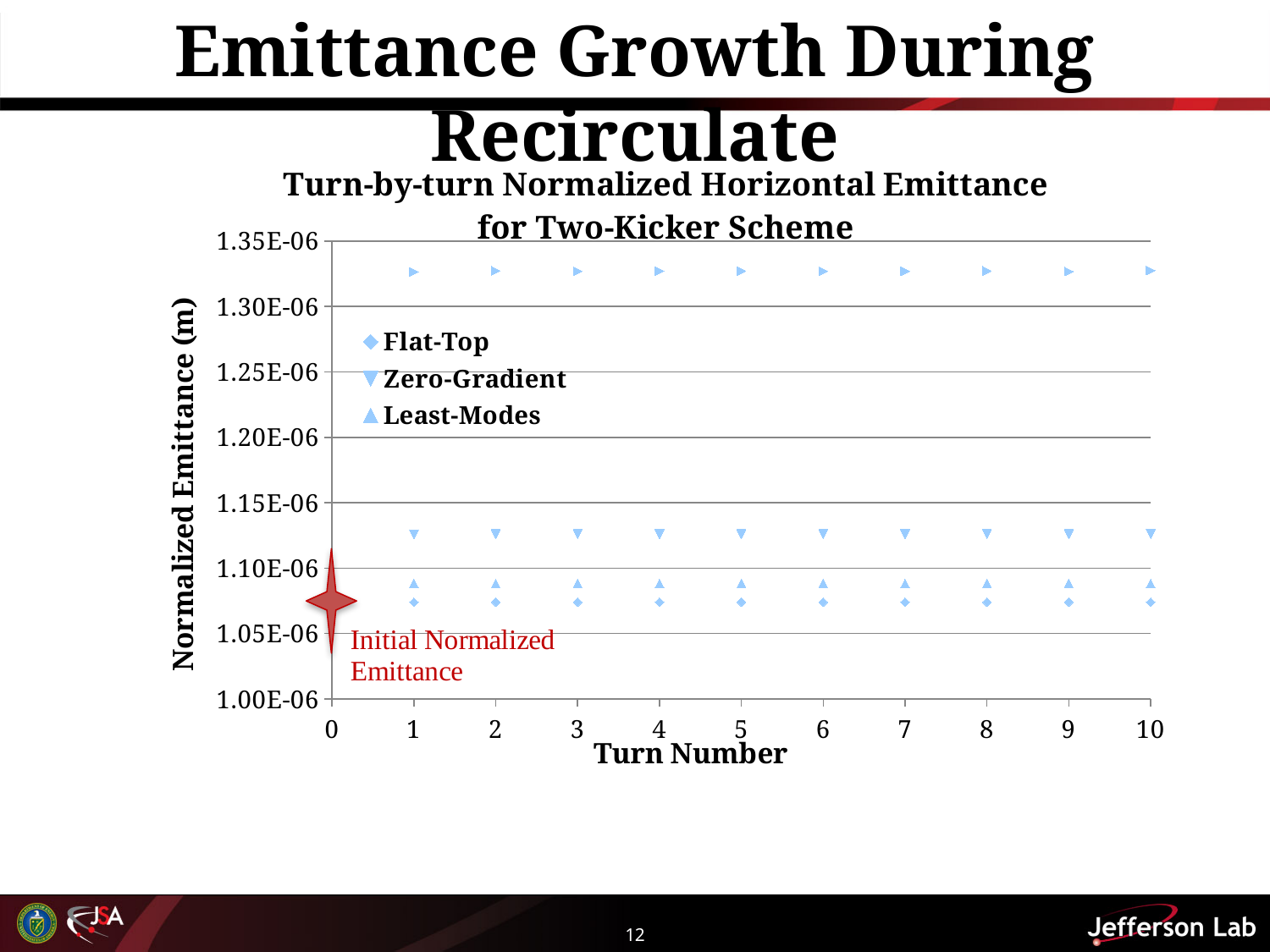
How many turn numbers are plotted for the Zero-Gradient series? 10 Is the value for Zero-Gradient at turn 5 greater or less than 1.10E-06? greater How many series does the chart legend list? 3 Which series has the larger value at turn 7, Zero-Gradient or Least-Modes? Zero-Gradient What kind of chart is shown on the slide? Scatter chart What is the label of the x axis? Turn Number Is the value for Least-Modes at turn 8 greater or less than 1.05E-06? greater What is the title of the chart? Turn-by-turn Normalized Horizontal Emittance for Two-Kicker Scheme Do the Flat-Top values rise, fall, or stay flat as the turn number increases from 1 to 10? Stay flat Which series has the larger value at turn 4, Zero-Gradient or Flat-Top? Zero-Gradient Is the value for Zero-Gradient at turn 3 greater or less than 1.15E-06? less